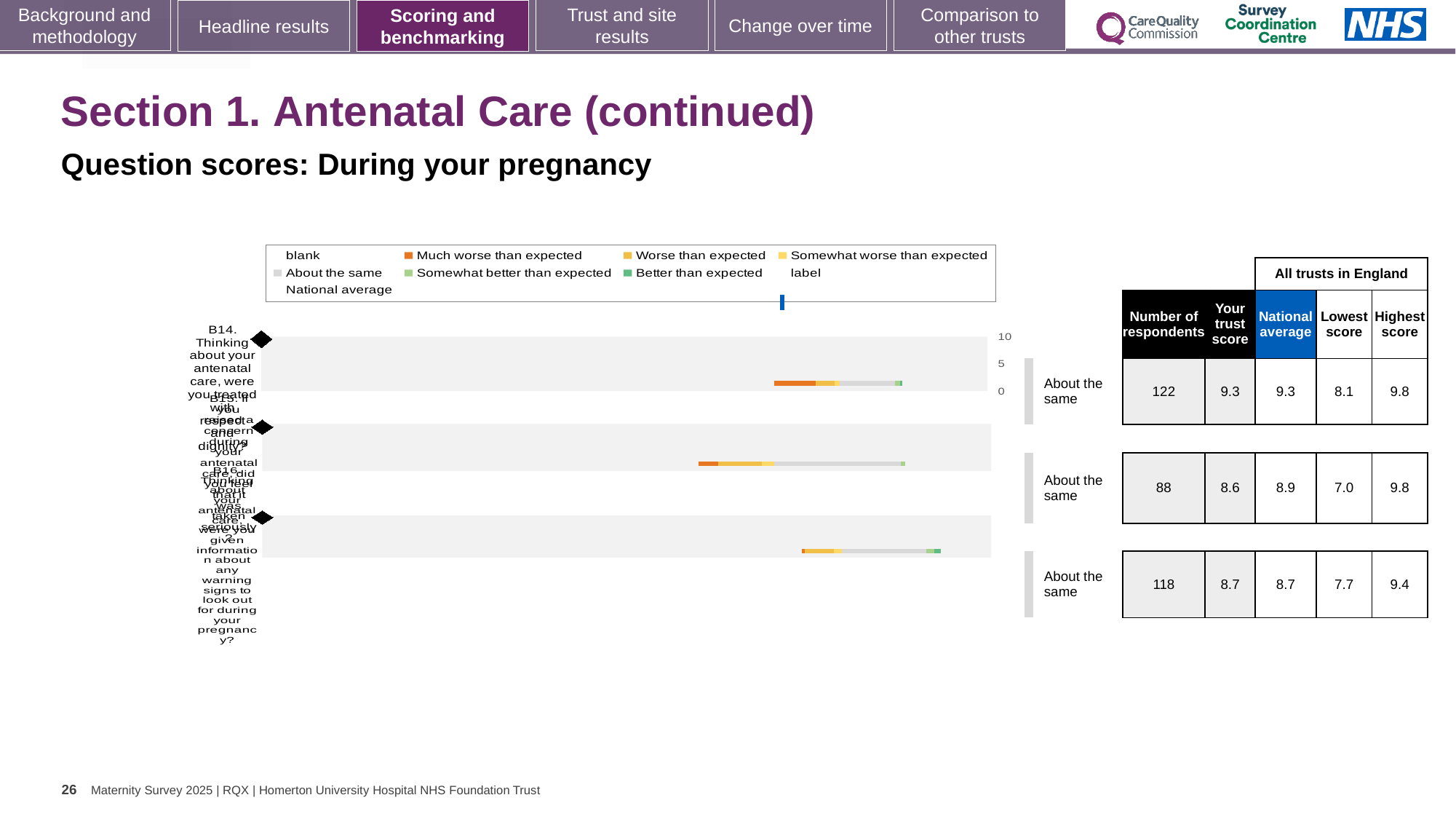
What benchmark category is shown next to each of the three bars in the chart? About the same How many question rows (bars) does the chart show? 3 What is the highest value shown on the chart's axis? 10 In the table beside the chart, what is the national average for the second row? 8.9 In the table beside the chart, what is the number of respondents for the first row (B14, treated with respect and dignity)? 122 In the table beside the chart, what is the lowest score for the second row? 7.0 In the table beside the chart, what is the trust score for the first row (B14)? 9.3 In the table beside the chart, what is the difference between the trust score and the national average for the second row? 0.3 In the table beside the chart, which row has more respondents, the first row or the third row? the first row (122) In the table beside the chart, what is the highest score for the third row? 9.4 What kind of chart is shown on the slide? bar chart In the table beside the chart, which row has the lowest trust score? the second row (8.6)